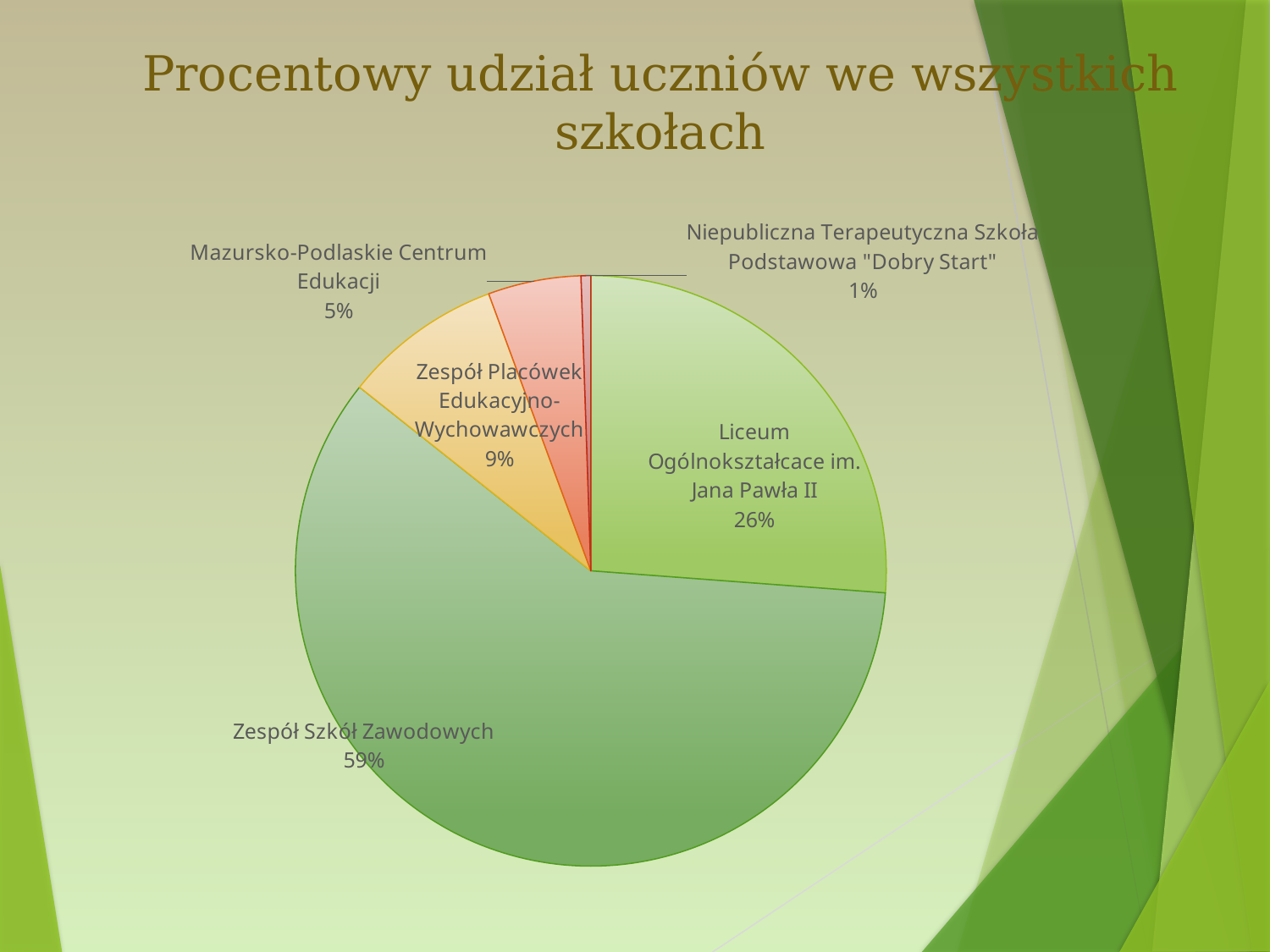
Which school has the smallest share of students? Niepubliczna Terapeutyczna Szkoła Podstawowa "Dobry Start" Which has a larger share, Zespół Placówek Edukacyjno-Wychowawczych or Mazursko-Podlaskie Centrum Edukacji? Zespół Placówek Edukacyjno-Wychowawczych What is the title of the chart on the slide? Procentowy udział uczniów we wszystkich szkołach What kind of chart is shown on the slide? pie chart What percentage share does Zespół Placówek Edukacyjno-Wychowawczych have? 9% What percentage share does Mazursko-Podlaskie Centrum Edukacji have? 5% What percentage share does Zespół Szkół Zawodowych have? 59% What percentage share does Liceum Ogólnokształcace im. Jana Pawła II have? 26% Which school has the largest share of students? Zespół Szkół Zawodowych What is the difference in percentage points between Zespół Szkół Zawodowych and Liceum Ogólnokształcace im. Jana Pawła II? 33 percentage points What percentage share does Niepubliczna Terapeutyczna Szkoła Podstawowa "Dobry Start" have? 1% How many slices does the pie chart have? 5